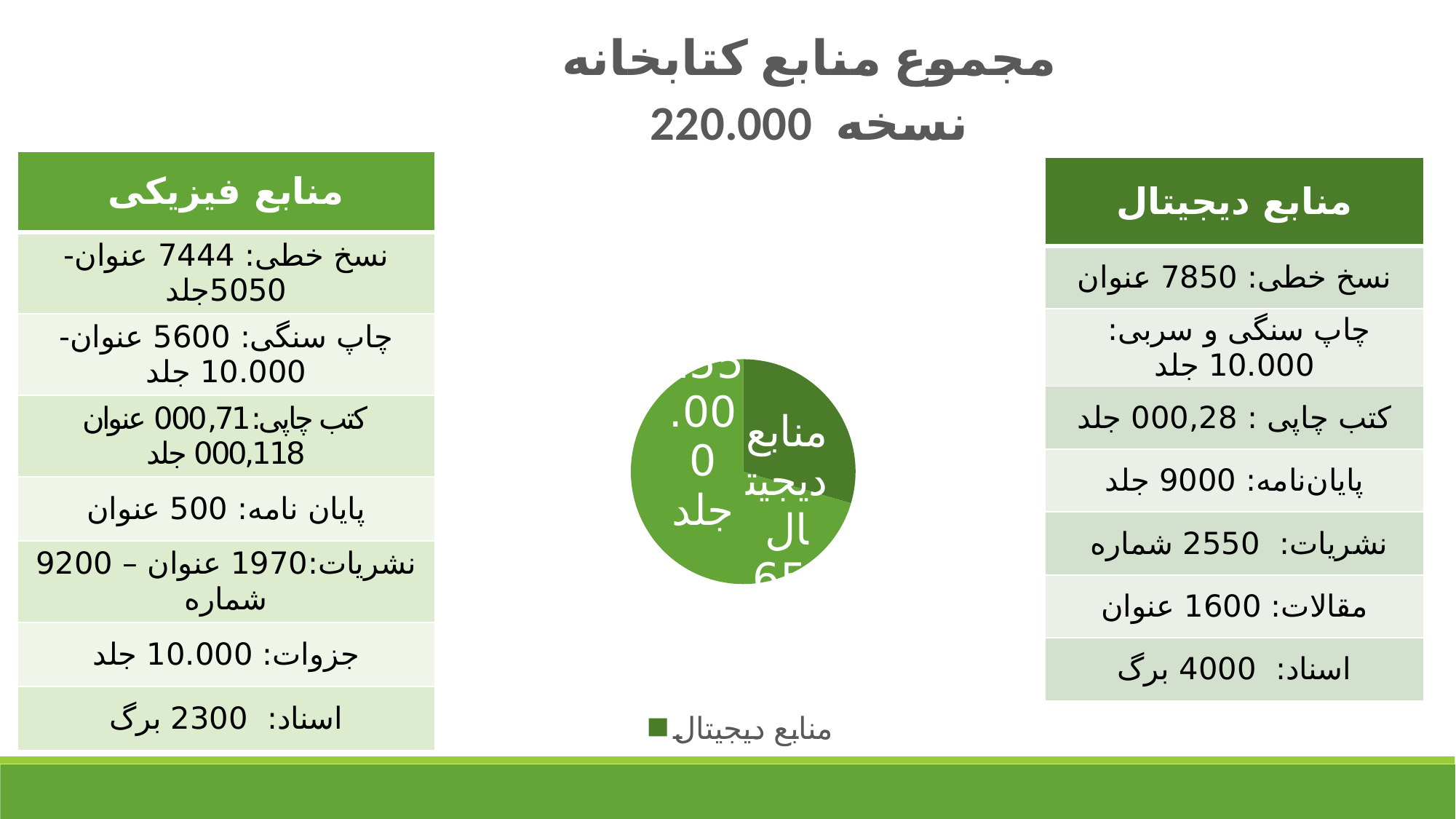
Which slice of the pie chart is larger, the dark green slice or the light green slice? the light green slice What is the legend entry shown below the pie chart? منابع دیجیتال What colour family is used for the slices of the pie chart? green What kind of chart is shown in the centre of the slide? pie chart How many slices does the pie chart have? 2 How many entries does the legend below the pie chart list? 1 Is the dark green slice of the pie chart more or less than half of the pie? less